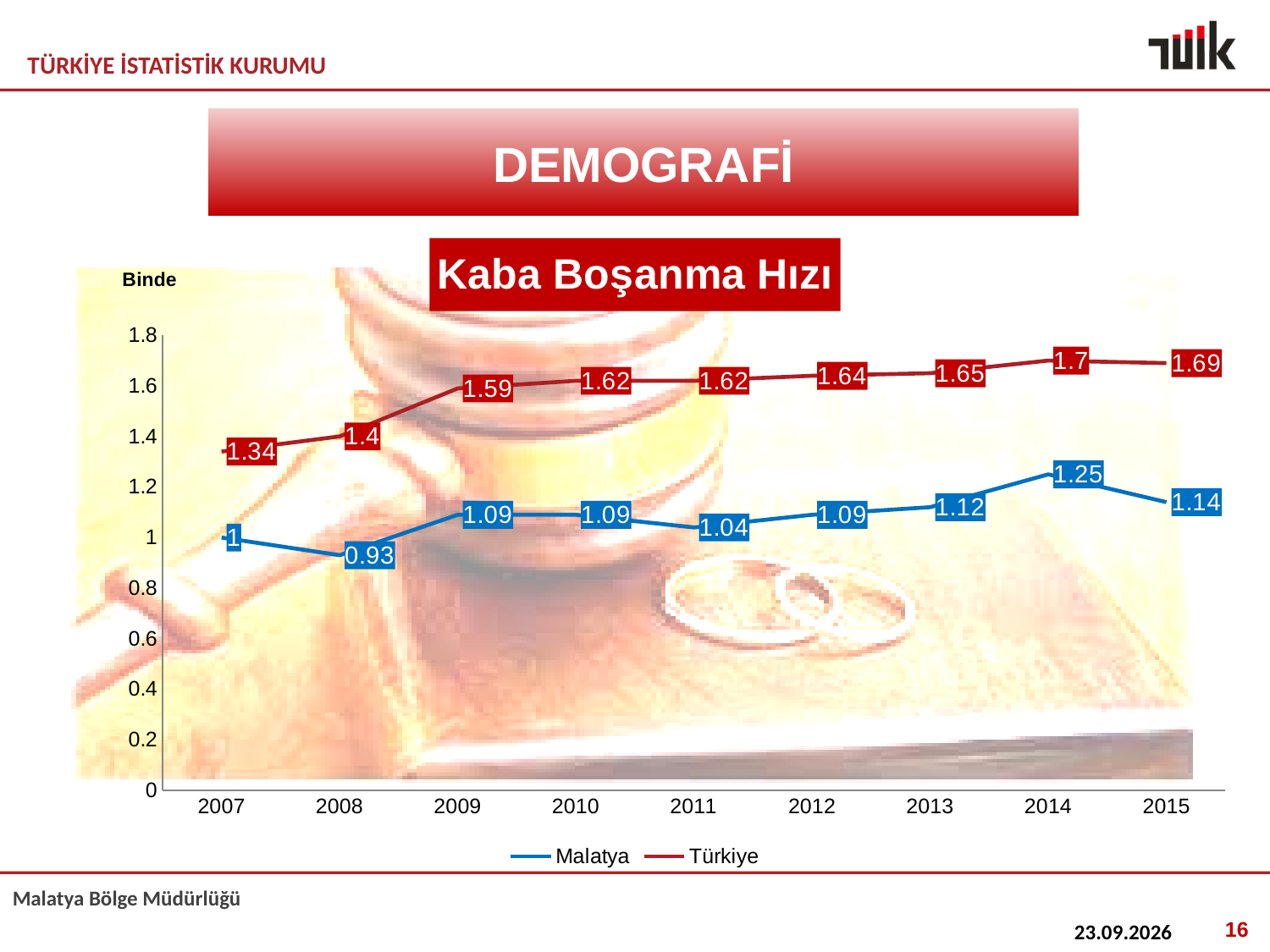
What is the difference between the Türkiye and Malatya values in 2015? 0.55 In which year is the Türkiye value lowest? 2007 What is the value for Türkiye in 2014? 1.7 Which series has the larger value in 2011, Malatya or Türkiye? Türkiye What type of chart is shown on the slide? line chart How many years are shown on the x axis? 9 In which year is the Malatya value highest? 2014 How many series does the legend list? 2 What is the title of the chart? Kaba Boşanma Hızı What is the value for Malatya in 2008? 0.93 What is the value for Malatya in 2015? 1.14 Does the Türkiye series generally rise or fall from 2007 to 2014? rise